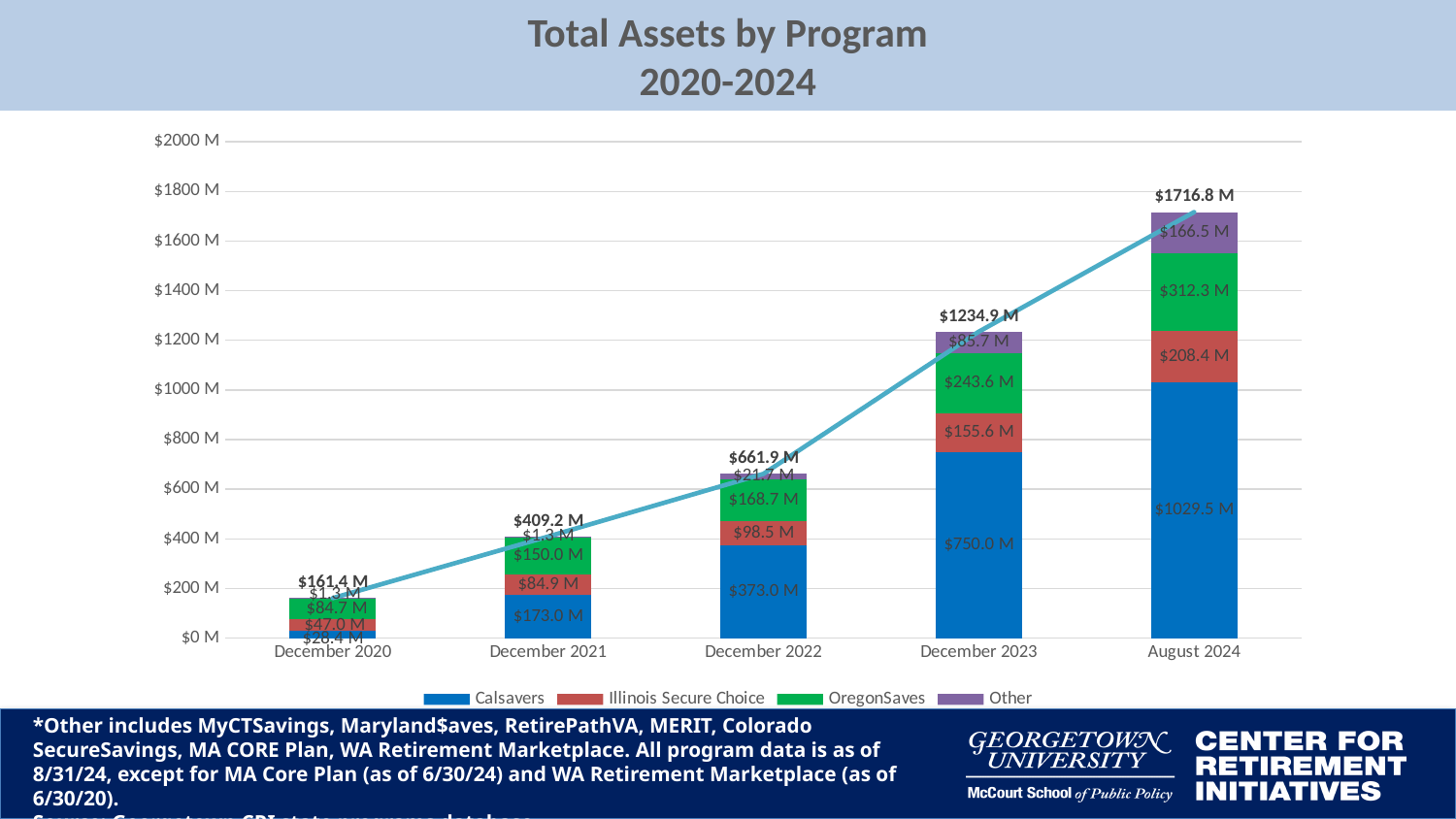
What is the value for Calsavers in August 2024? $1029.5 M Which period has the highest total assets? August 2024 What is the value for OregonSaves in December 2022? $168.7 M How many time periods are shown on the x axis? 5 Do the total assets rise or fall from December 2020 to August 2024? Rise How many series does the legend list? 4 What kind of chart is this? Stacked bar chart with a line Which period has the lowest total assets? December 2020 In December 2021, which is larger: the Calsavers value or the OregonSaves value? Calsavers What is the value for Illinois Secure Choice in December 2020? $47.0 M What is the total of the stacked bar for December 2023? $1234.9 M What is the difference between the Calsavers value in December 2023 and in December 2022? $377.0 M